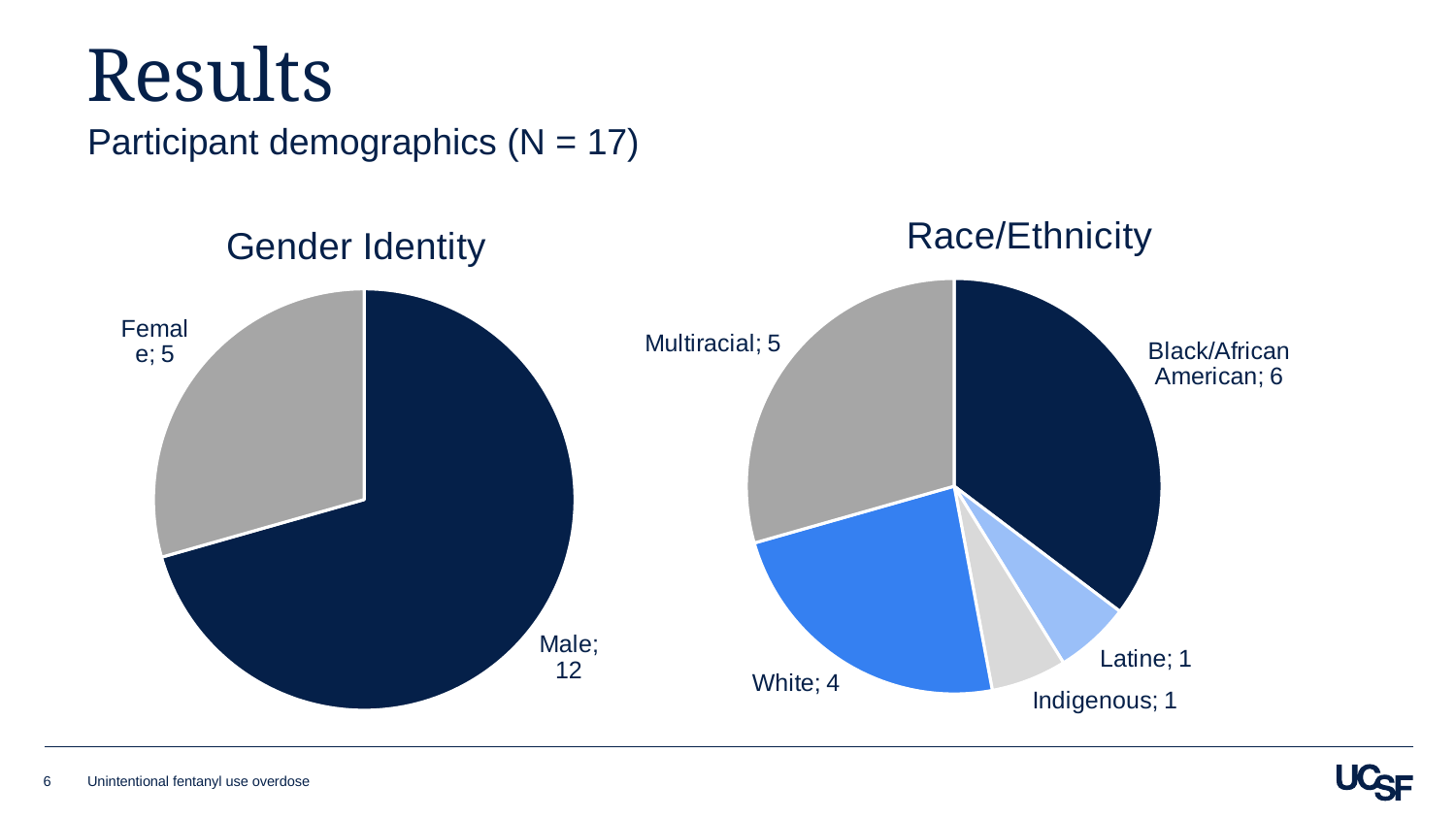
In the Gender Identity chart, how many participants are Male? 12 In the Race/Ethnicity chart, how many participants are Black/African American? 6 In the Race/Ethnicity chart, how many participants are White? 4 In the Gender Identity chart, how many participants are Female? 5 In the Race/Ethnicity chart, which is larger, Multiracial or White? Multiracial In the Gender Identity chart, what is the total number of participants across both slices? 17 In the Race/Ethnicity chart, what is the difference between the Black/African American and Latine counts? 5 In the Gender Identity chart, what is the difference between the Male and Female counts? 7 What kind of chart is the Gender Identity chart? Pie chart In the Race/Ethnicity chart, what colour is the White slice? Blue In the Race/Ethnicity chart, how many categories are shown? 5 In the Race/Ethnicity chart, which category has the largest slice? Black/African American